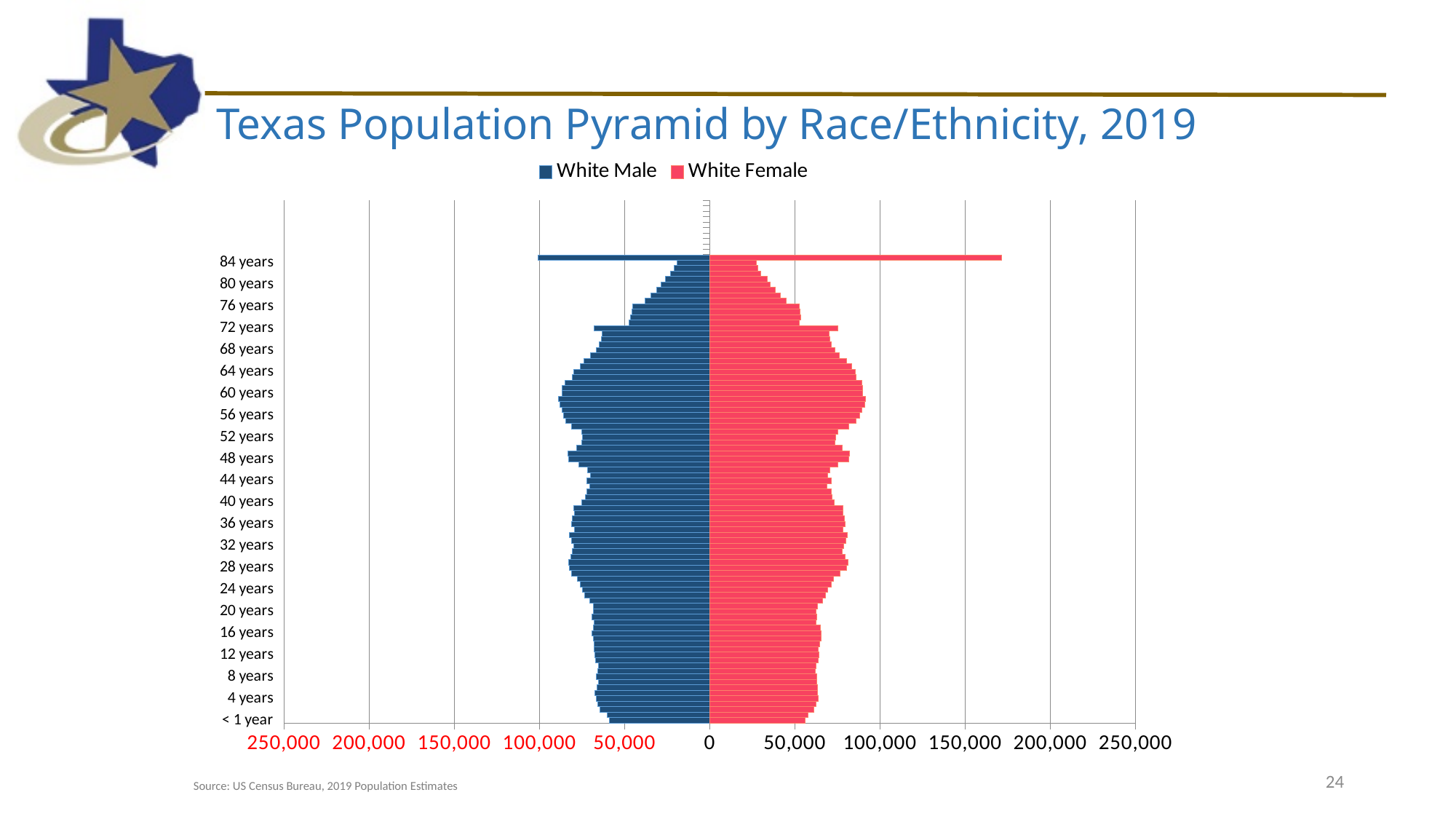
At 76 years, which is larger: the White Male value or the White Female value? White Female Is the White Male value for 72 years greater or less than 50,000? greater Is the White Female value for 60 years greater or less than 50,000? greater How many series does the legend list? 2 What kind of chart is shown on the slide? Bar chart (population pyramid) Is the White Male value for 80 years greater or less than 50,000? less What is the title of the chart on the slide? Texas Population Pyramid by Race/Ethnicity, 2019 Which series is shown in dark blue? White Male At 84 years, which is larger: the White Male value or the White Female value? White Female